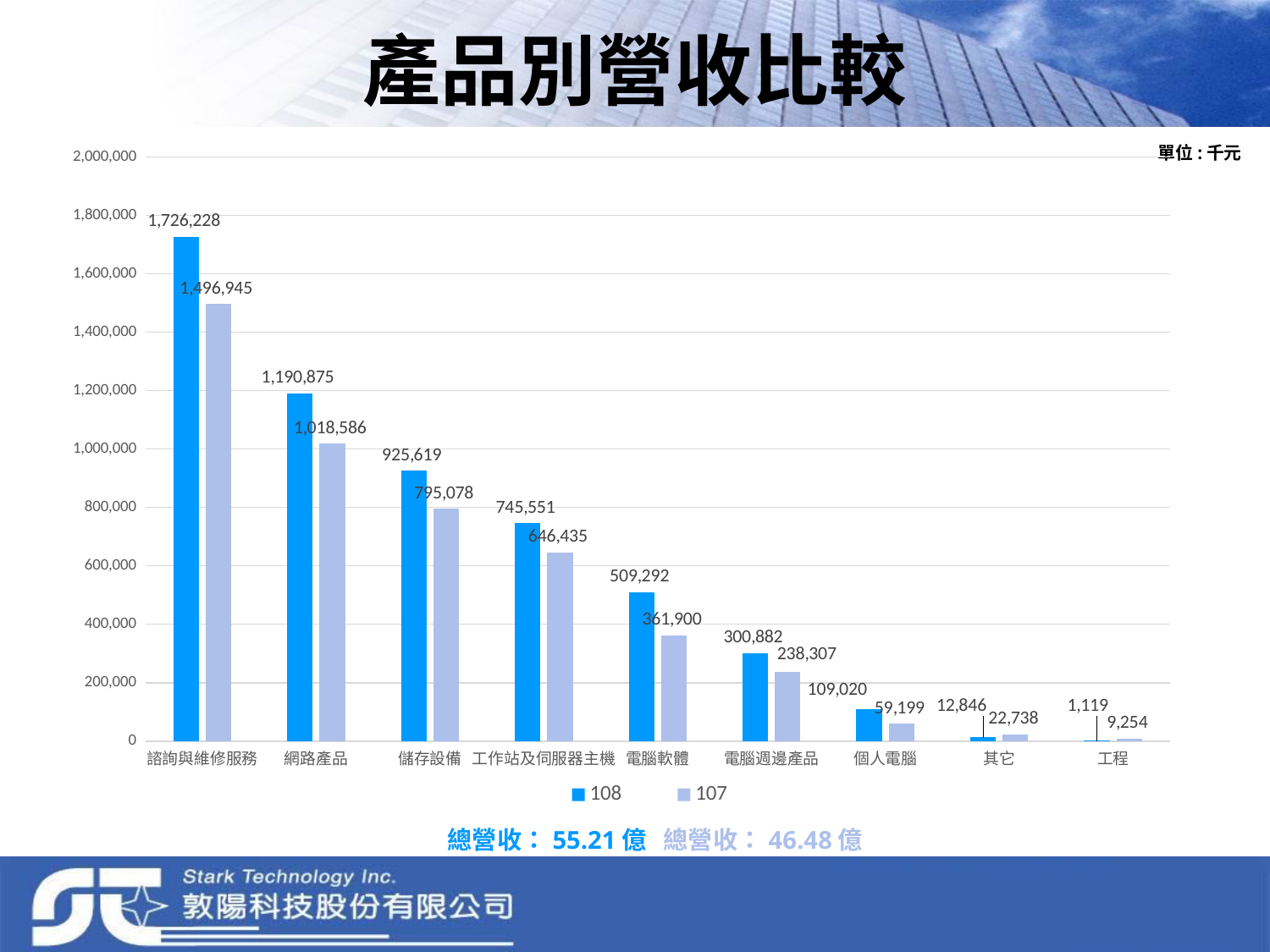
What unit is stated for the chart values? 千元 What is the value for 電腦軟體 in the 107 series? 361,900 What is the value for 諮詢與維修服務 in the 108 series? 1,726,228 How many product categories are shown on the x axis? 9 Do the 108 series values rise or fall from left to right along the x axis? fall Which category has the highest value in the 108 series? 諮詢與維修服務 What is the difference between the 108 and 107 values for 網路產品? 172,289 For 其它, which series has the larger value, 108 or 107? 107 Which category has the lowest value in the 107 series? 工程 How many series does the legend list? 2 What is the value for 工程 in the 108 series? 1,119 What kind of chart is shown on the slide? bar chart